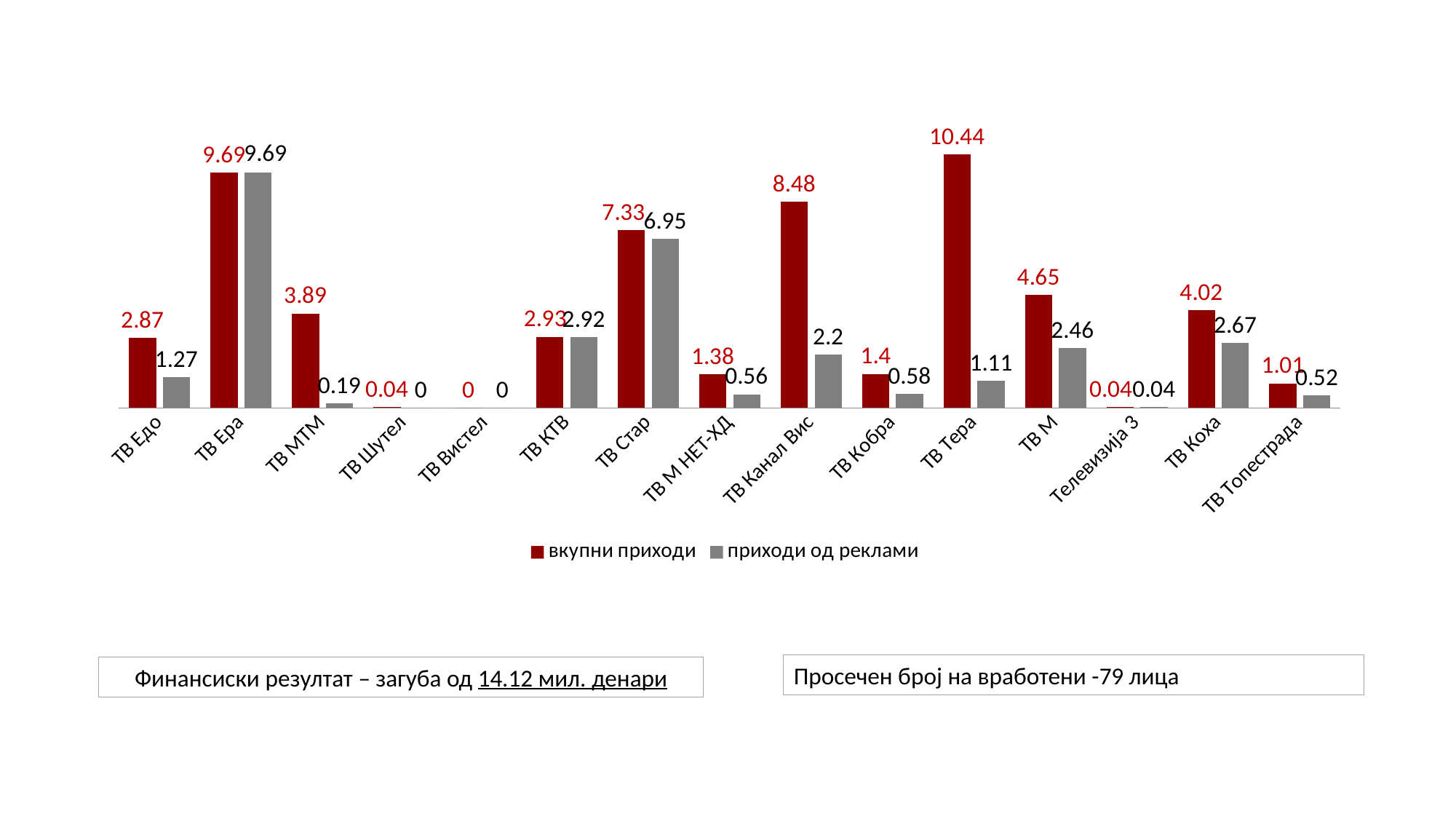
What colour are the bars for the series "вкупни приходи"? red Which category has the lowest value for "вкупни приходи"? ТВ Вистел How many series does the legend list? 2 What is the value of "вкупни приходи" for ТВ Тера? 10.44 Which is larger: "вкупни приходи" for ТВ М or for ТВ Коха? ТВ М What kind of chart is shown on the slide? bar chart Which category has the highest value for "приходи од реклами"? ТВ Ера What is the value of "приходи од реклами" for ТВ Канал Вис? 2.2 Which category has the highest value for "вкупни приходи"? ТВ Тера What is the value of "приходи од реклами" for ТВ Стар? 6.95 What is the difference between "вкупни приходи" and "приходи од реклами" for ТВ Канал Вис? 6.28 How many categories are shown on the x axis? 15